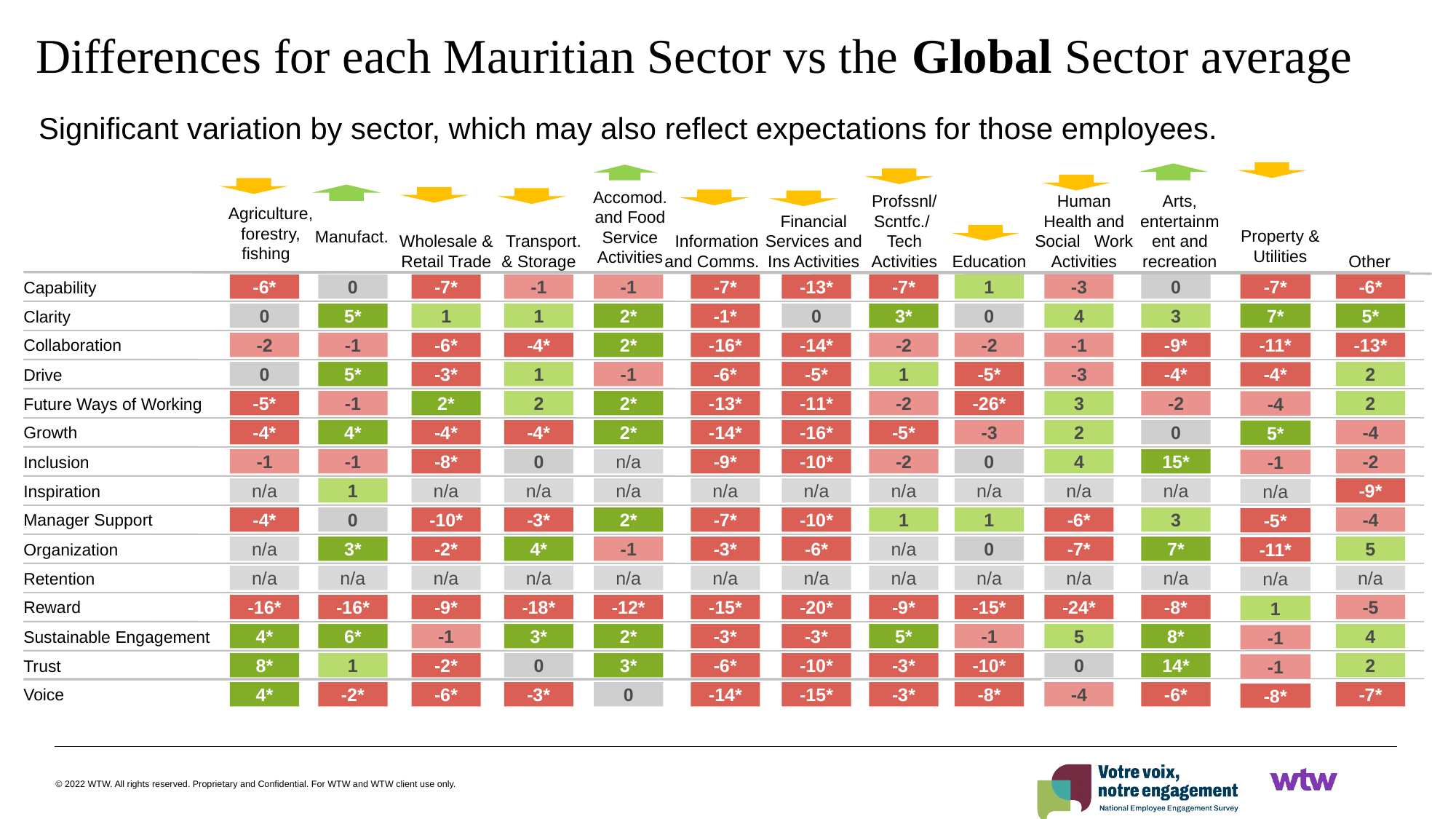
What kind of visualization is shown on the slide? Heatmap table What is the difference between the Reward values for Financial Services and Ins Activities (-20*) and Property & Utilities (1)? 21 Which sector has the highest value in the Reward row? Property & Utilities What is the value for Reward in the Education sector? -15* What is the value for Trust in the Agriculture, forestry, fishing sector? 8* How many row categories (e.g. Capability, Clarity, ...) are listed in the table? 15 Which is larger: the Clarity value for Property & Utilities or the Clarity value for Manufact.? Property & Utilities Which sector has the lowest value in the Reward row? Human Health and Social Work Activities What is the value for Future Ways of Working in the Education sector? -26* Which row shows n/a for every sector? Retention How many sector columns are shown in the table? 13 What is the value for Inclusion in the Arts, entertainment and recreation sector? 15*